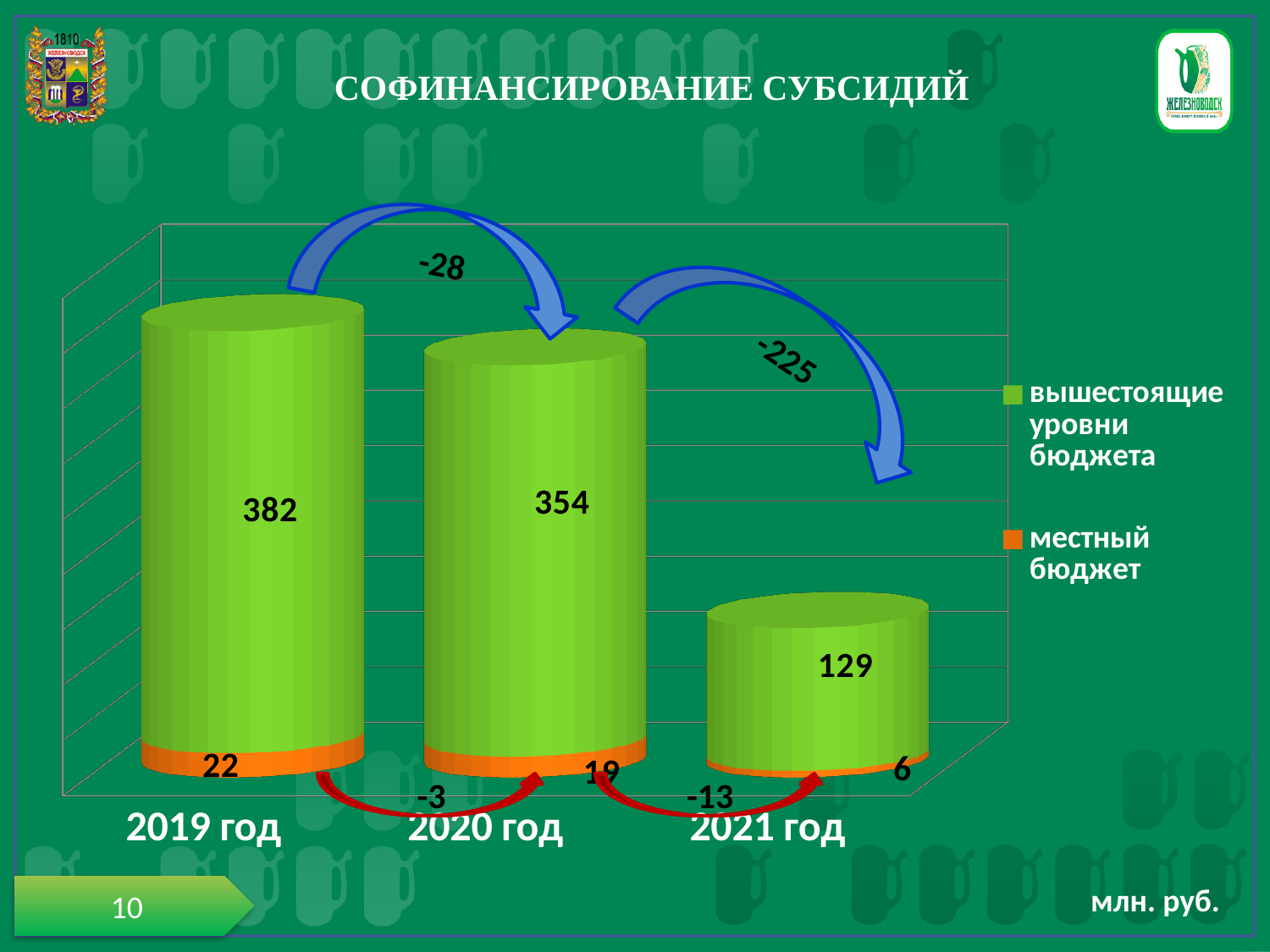
Which year has the highest value for вышестоящие уровни бюджета? 2019 год Which year has the lowest value for местный бюджет? 2021 год What is the difference between the вышестоящие уровни бюджета values for 2020 год and 2021 год? 225 What is the total of the stacked bar for 2020 год? 373 What is the value for местный бюджет in 2020 год? 19 What is the value for вышестоящие уровни бюджета in 2021 год? 129 How many series does the legend list? 2 Do the values for вышестоящие уровни бюджета rise or fall from 2019 год to 2021 год? fall Which is larger: местный бюджет in 2019 год or in 2020 год? 2019 год How many years are shown on the x axis? 3 What is the value for местный бюджет in 2021 год? 6 What is the value for вышестоящие уровни бюджета in 2019 год? 382